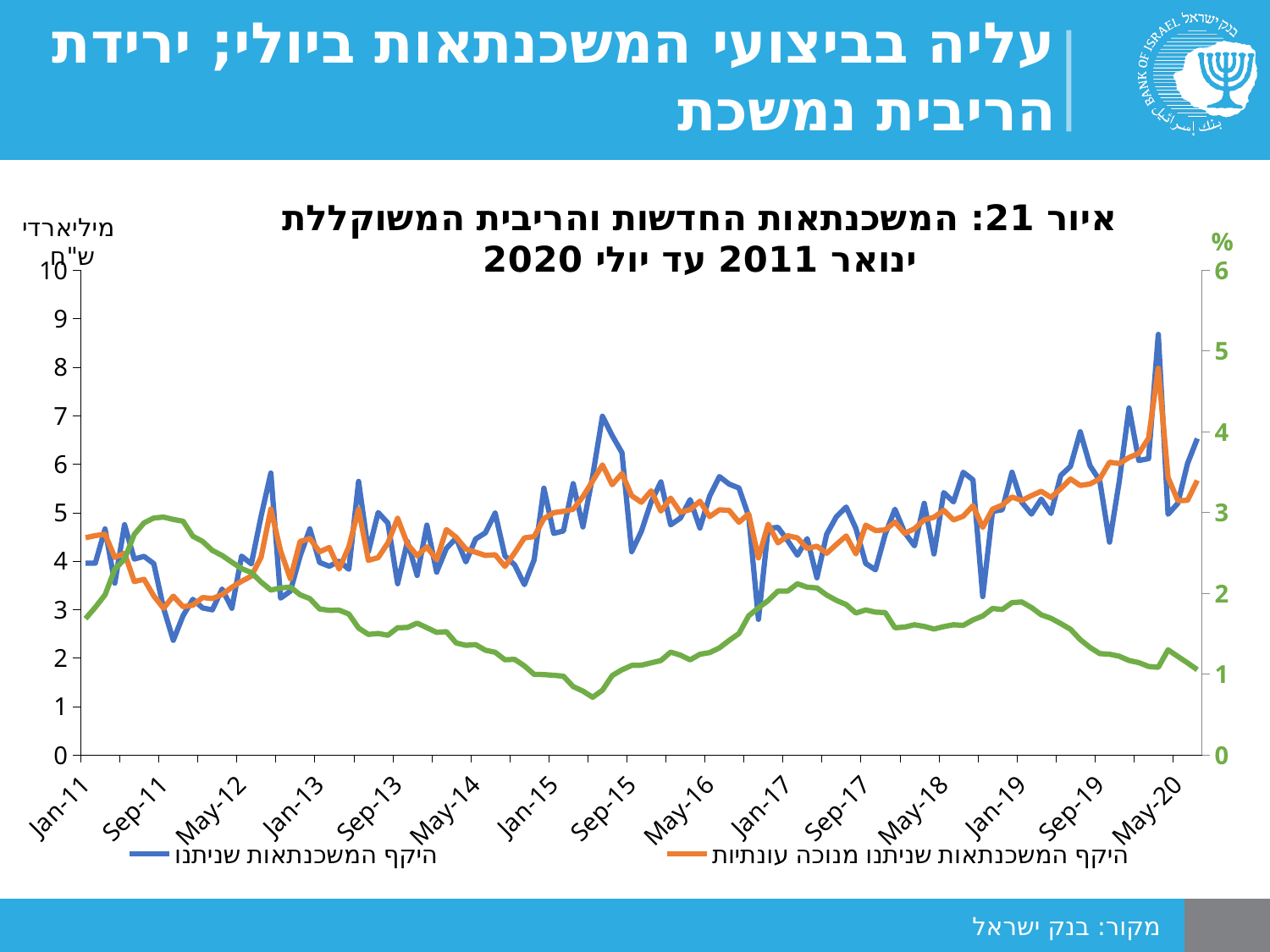
Does the orange line (היקף המשכנתאות שניתנו מנוכה עונתיות) rise or fall between Jan-17 and Sep-19? rise Is the peak of the blue line (היקף המשכנתאות שניתנו) around Sep-15 greater or less than 6 on the left axis? greater Is the peak value of the blue line (היקף המשכנתאות שניתנו) in early 2020 greater or less than 8 on the left axis? greater Does the green line rise or fall between Jan-11 and Sep-15? fall What kind of chart is shown on the slide? line chart Does the green line rise or fall between Sep-15 and Jan-17? rise What is the title of the chart? איור 21: המשכנתאות החדשות והריבית המשוקללת ינואר 2011 עד יולי 2020 Is the value of the blue line (היקף המשכנתאות שניתנו) at Jan-11 greater or less than 5 on the left axis? less How many series does the chart's legend list? 2 What unit is shown on the left vertical axis of the chart? מיליארדי ש"ח